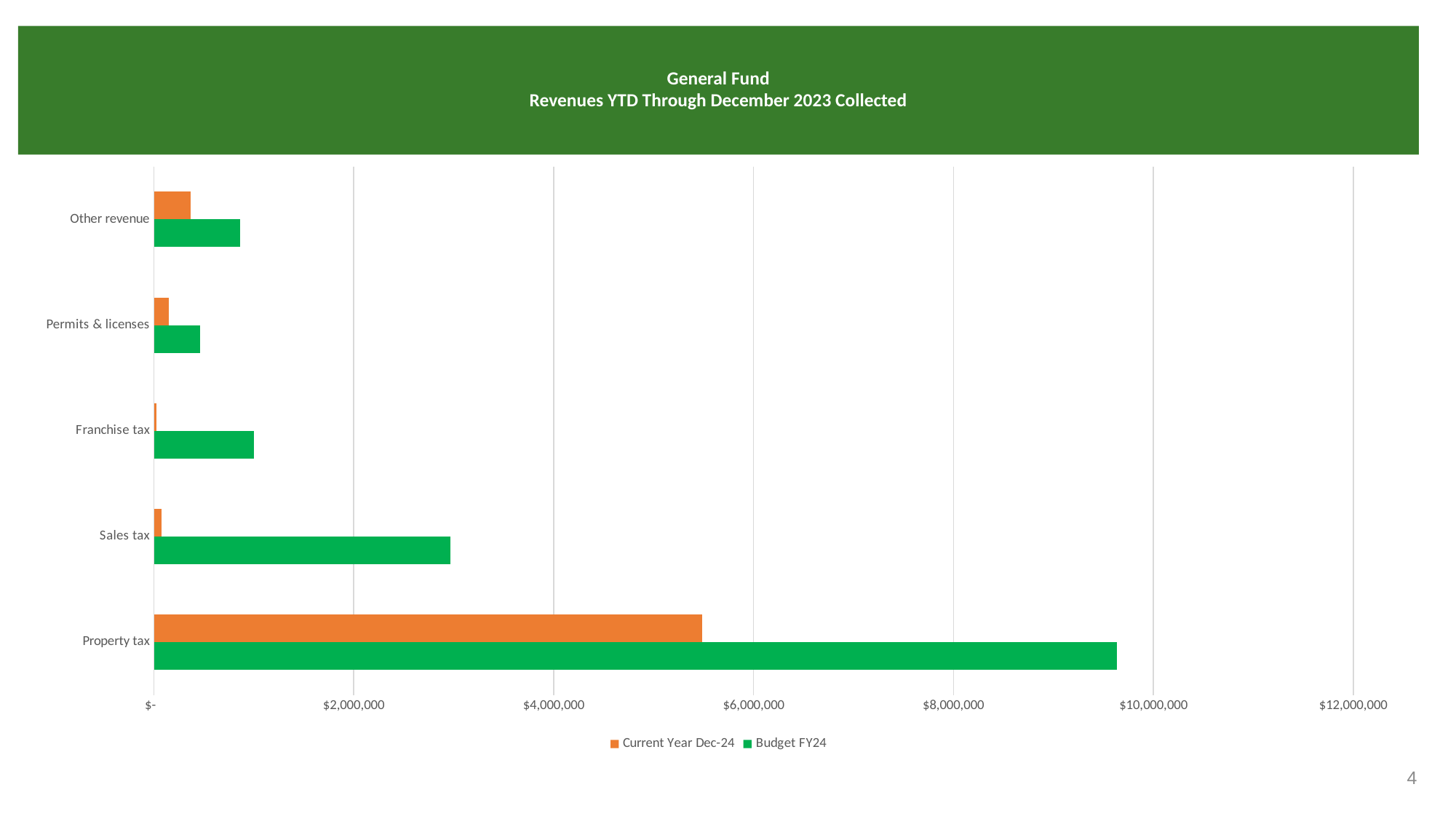
Which category has the lowest Budget FY24 value? Permits & licenses What kind of chart is shown on the slide? bar chart Is the Current Year Dec-24 value for Property tax greater or less than $6,000,000? less Which is larger: the Budget FY24 value for Sales tax or the Budget FY24 value for Franchise tax? Sales tax Which category has the lowest Current Year Dec-24 value? Franchise tax Which category has the highest Budget FY24 value? Property tax Which is larger: the Current Year Dec-24 value for Other revenue or the Current Year Dec-24 value for Permits & licenses? Other revenue What colour represents the Budget FY24 series in the chart? green Is the Budget FY24 value for Sales tax greater or less than $2,000,000? greater How many series does the legend list? 2 How many revenue categories are shown on the chart? 5 Is the Budget FY24 value for Property tax greater or less than $8,000,000? greater